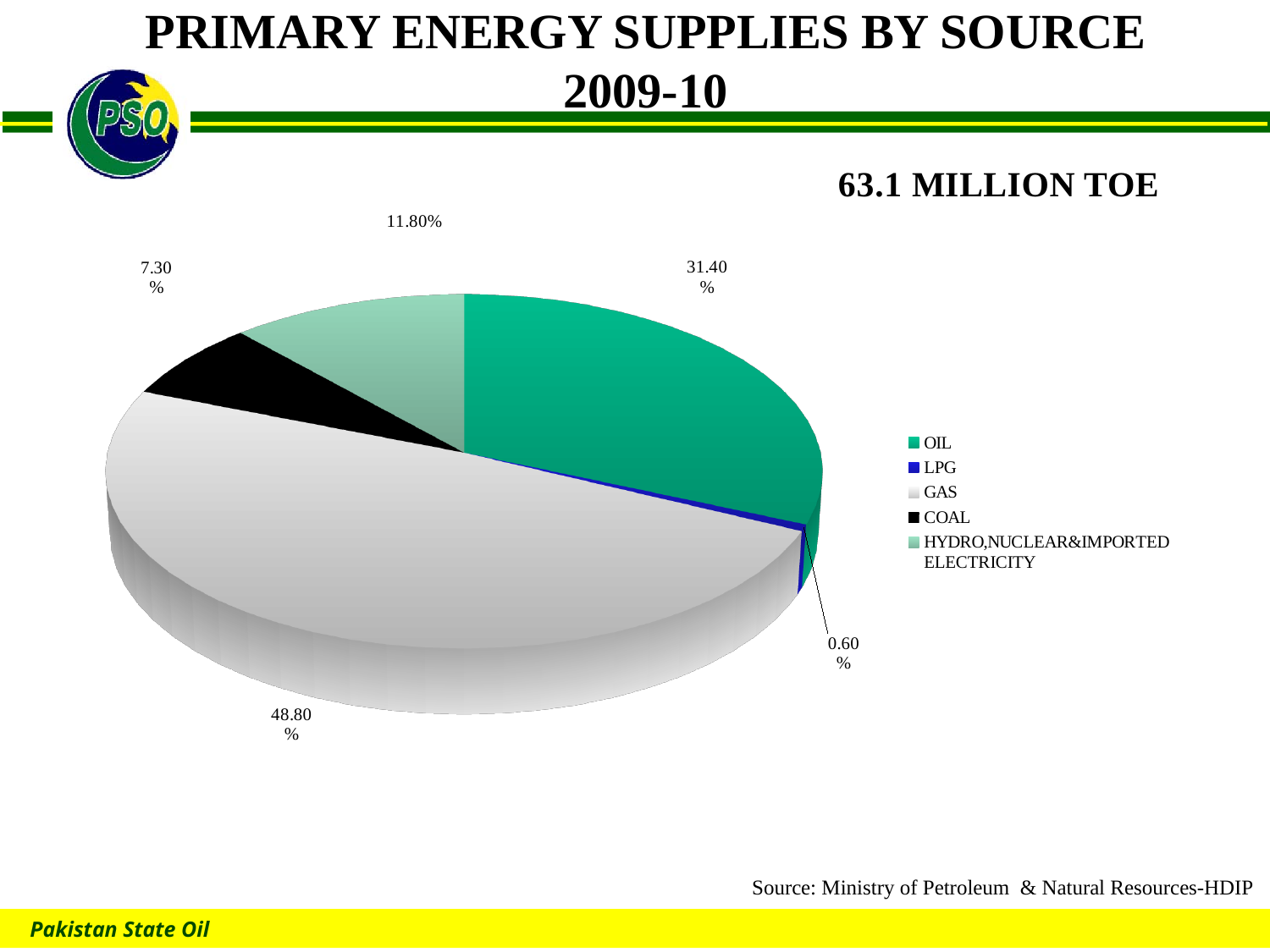
What is the difference in percentage points between the GAS share and the OIL share? 17.40 What total quantity of primary energy supplies is stated on the slide? 63.1 MILLION TOE Which source has the largest share of primary energy supplies? GAS What share of primary energy supplies does GAS account for? 48.80% What type of chart is shown on the slide? Pie chart Which has a larger share, COAL or HYDRO,NUCLEAR&IMPORTED ELECTRICITY? HYDRO,NUCLEAR&IMPORTED ELECTRICITY Which source has the smallest share of primary energy supplies? LPG What share of primary energy supplies does LPG account for? 0.60% What share of primary energy supplies does OIL account for? 31.40% What share of primary energy supplies does COAL account for? 7.30% How many sources are shown in the pie chart? 5 What share of primary energy supplies does HYDRO,NUCLEAR&IMPORTED ELECTRICITY account for? 11.80%